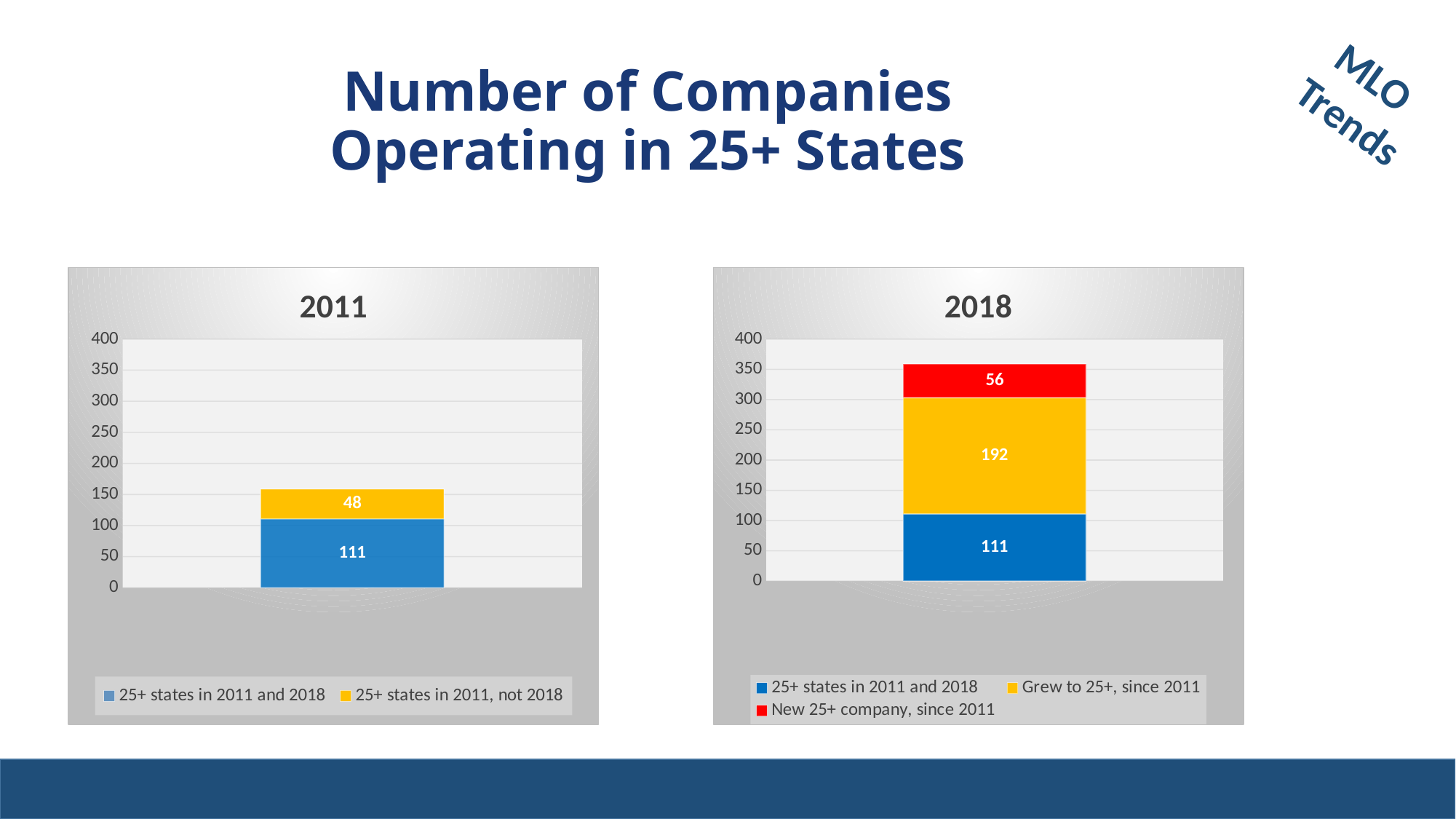
In the 2018 chart, which series has the largest value? Grew to 25+, since 2011 What kind of chart is the 2011 chart? Stacked bar chart In the 2018 chart, what is the difference between 'Grew to 25+, since 2011' and 'New 25+ company, since 2011'? 136 In the 2011 chart, what is the value for '25+ states in 2011 and 2018'? 111 In the 2011 chart, which is larger: '25+ states in 2011 and 2018' or '25+ states in 2011, not 2018'? 25+ states in 2011 and 2018 In the 2018 chart, what is the value for 'New 25+ company, since 2011'? 56 In the 2018 chart, which series has the smallest value? New 25+ company, since 2011 In the 2018 chart, what is the value for 'Grew to 25+, since 2011'? 192 How many series does the legend of the 2018 chart list? 3 In the 2018 chart, what is the total of the stacked bar? 359 In the 2011 chart, what is the total of the stacked bar? 159 In the 2011 chart, what is the value for '25+ states in 2011, not 2018'? 48